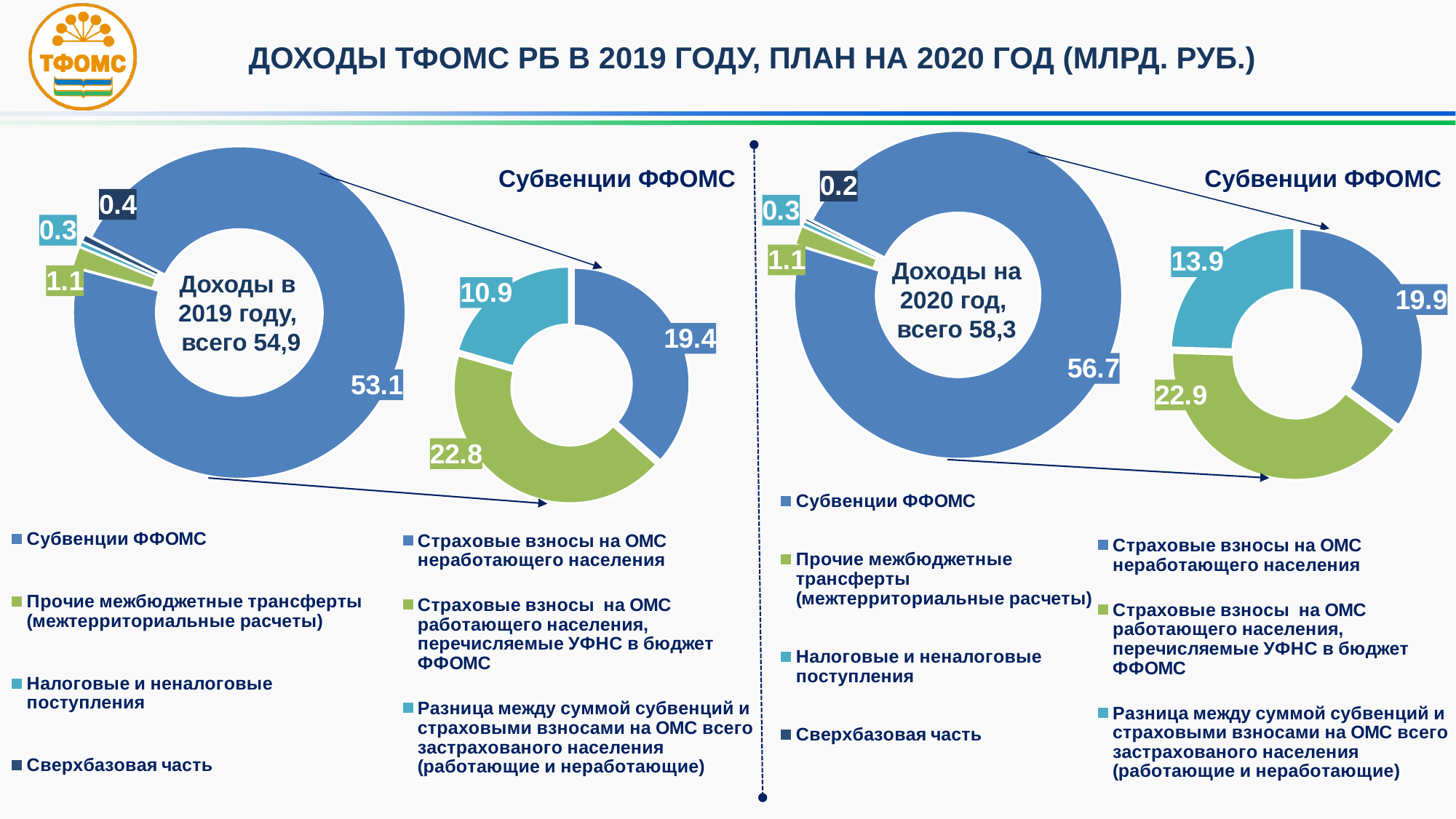
In the 2019 income donut chart, which category has the smallest value? Налоговые и неналоговые поступления In the 2019 income donut chart ("Доходы в 2019 году"), what is the value for Субвенции ФФОМС? 53.1 What is the difference between Субвенции ФФОМС in the 2020 income chart and in the 2019 income chart? 3.6 Which is larger: Страховые взносы на ОМС неработающего населения in the 2019 breakdown chart or in the 2020 breakdown chart? 2020 (19.9) In the 2020 income donut chart, what is the value for Сверхбазовая часть? 0.2 In the 2020 Субвенции ФФОМС breakdown donut chart, which category has the largest value? Страховые взносы на ОМС работающего населения What type of chart is used for the 2019 income breakdown? Donut (pie) chart In the 2019 Субвенции ФФОМС breakdown donut chart, what is the value for Страховые взносы на ОМС работающего населения? 22.8 In the 2019 Субвенции ФФОМС breakdown donut chart, what is the difference between Страховые взносы на ОМС работающего населения and Страховые взносы на ОМС неработающего населения? 3.4 In the 2020 income donut chart ("Доходы на 2020 год"), what is the value for Субвенции ФФОМС? 56.7 In the 2020 Субвенции ФФОМС breakdown donut chart, what is the value for Разница между суммой субвенций и страховыми взносами на ОМС? 13.9 How many categories does the legend of the 2019 income donut chart list? 4